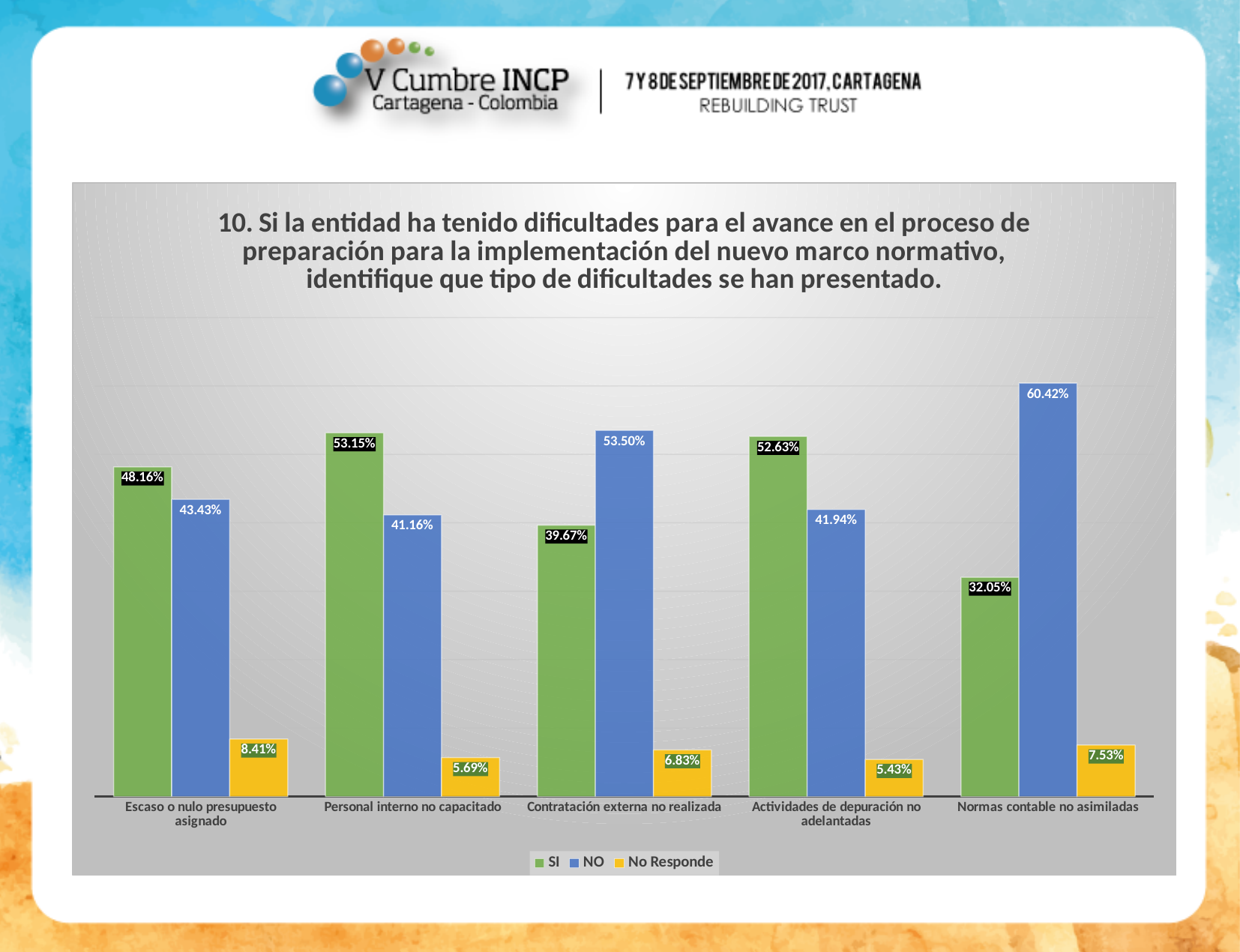
What is the No Responde value for "Actividades de depuración no adelantadas"? 5.43% Which colour represents the NO series in the legend? Blue What is the SI value for "Escaso o nulo presupuesto asignado"? 48.16% For "Actividades de depuración no adelantadas", which is larger, the SI value or the NO value? SI What kind of chart is shown on the slide? Bar chart What is the NO value for "Normas contable no asimiladas"? 60.42% How many categories are shown on the x axis? 5 Which category has the highest No Responde value? Escaso o nulo presupuesto asignado How many series does the legend list? 3 What is the difference between the NO and SI values for "Contratación externa no realizada"? 13.83% Which category has the lowest NO value? Personal interno no capacitado Which category has the highest SI value? Personal interno no capacitado